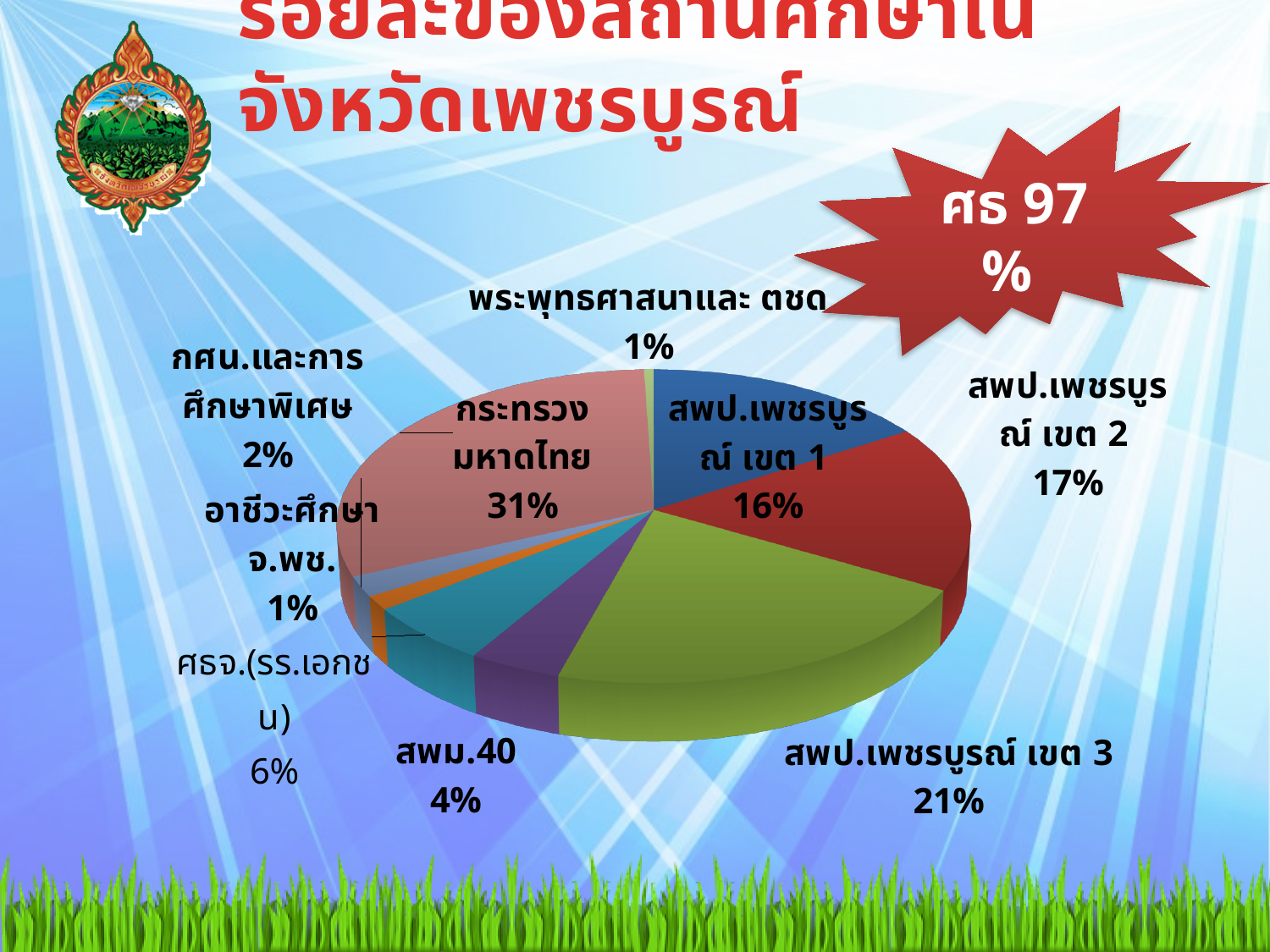
How many categories (slices) are labelled in the pie chart? 9 What percentage is shown for สพม.40? 4% What kind of chart is shown on the slide? pie chart Which is larger, the share for สพป.เพชรบูรณ์ เขต 2 or the share for สพป.เพชรบูรณ์ เขต 1? สพป.เพชรบูรณ์ เขต 2 What percentage is shown for สพป.เพชรบูรณ์ เขต 3? 21% Which category has the largest share of the pie? กระทรวงมหาดไทย What percentage is shown in the red starburst shape on the slide? ศธ 97% What is the difference in percentage points between สพป.เพชรบูรณ์ เขต 3 and สพม.40? 17 What percentage is shown for ศธจ.(รร.เอกชน)? 6% What percentage is shown for กศน.และการศึกษาพิเศษ? 2% What is the difference in percentage points between กระทรวงมหาดไทย and สพป.เพชรบูรณ์ เขต 1? 15 What percentage of the pie is labelled for กระทรวงมหาดไทย? 31%